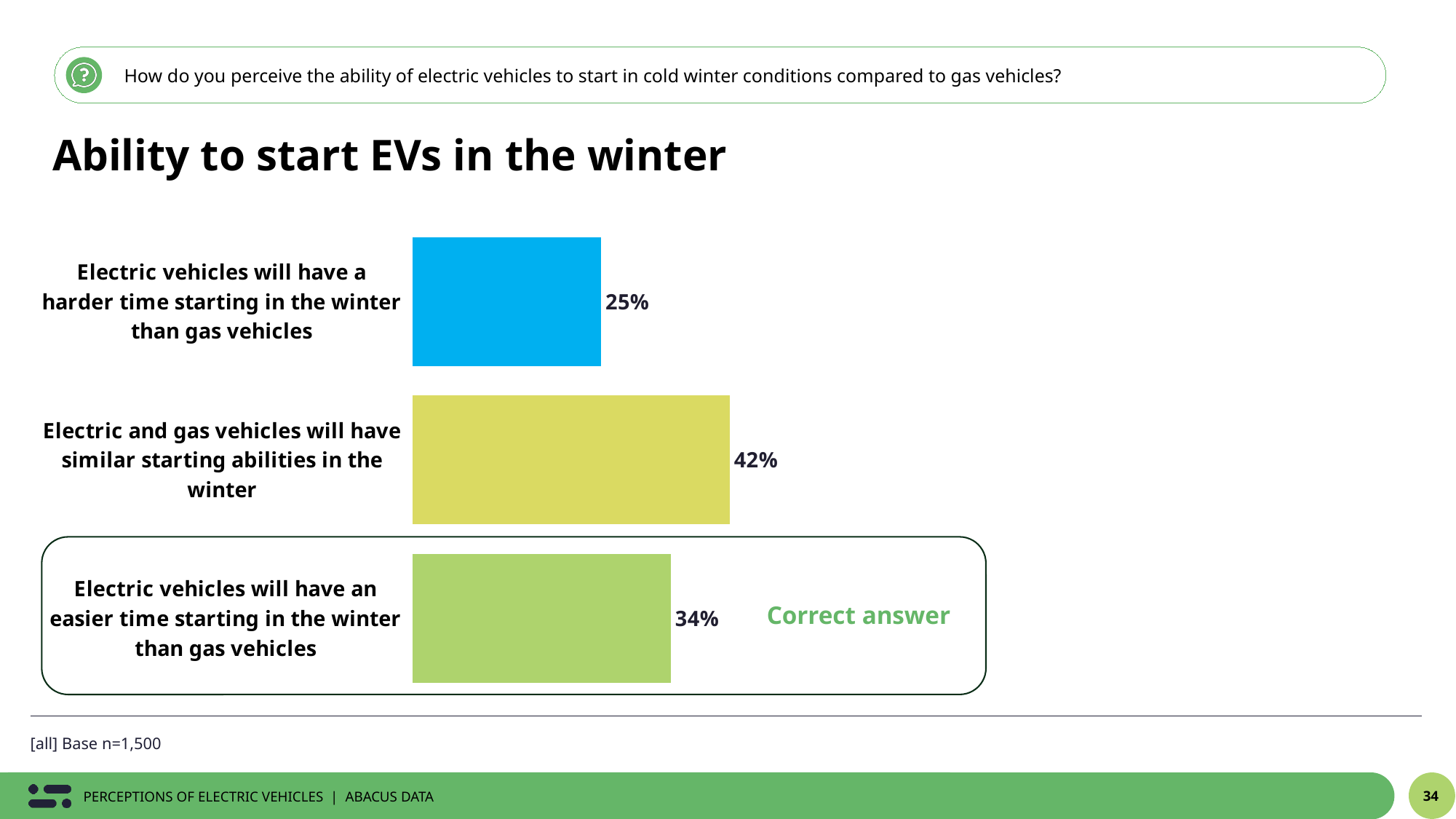
Which is larger: the percentage for 'easier time starting' or the percentage for 'harder time starting'? Easier time starting How many response options are shown in the chart? 3 Which response option has the lowest percentage? Electric vehicles will have a harder time starting in the winter than gas vehicles Which response option has the highest percentage? Electric and gas vehicles will have similar starting abilities in the winter What percentage of respondents said electric vehicles will have an easier time starting in the winter than gas vehicles? 34% What is the difference in percentage points between the 'similar starting abilities' response and the 'harder time starting' response? 17 What type of chart is shown on the slide? Bar chart Which response option is marked as the correct answer? Electric vehicles will have an easier time starting in the winter than gas vehicles What is the base sample size noted below the chart? n=1,500 What is the difference in percentage points between the 'easier time starting' response and the 'harder time starting' response? 9 What percentage of respondents said electric vehicles will have a harder time starting in the winter than gas vehicles? 25% What percentage of respondents said electric and gas vehicles will have similar starting abilities in the winter? 42%